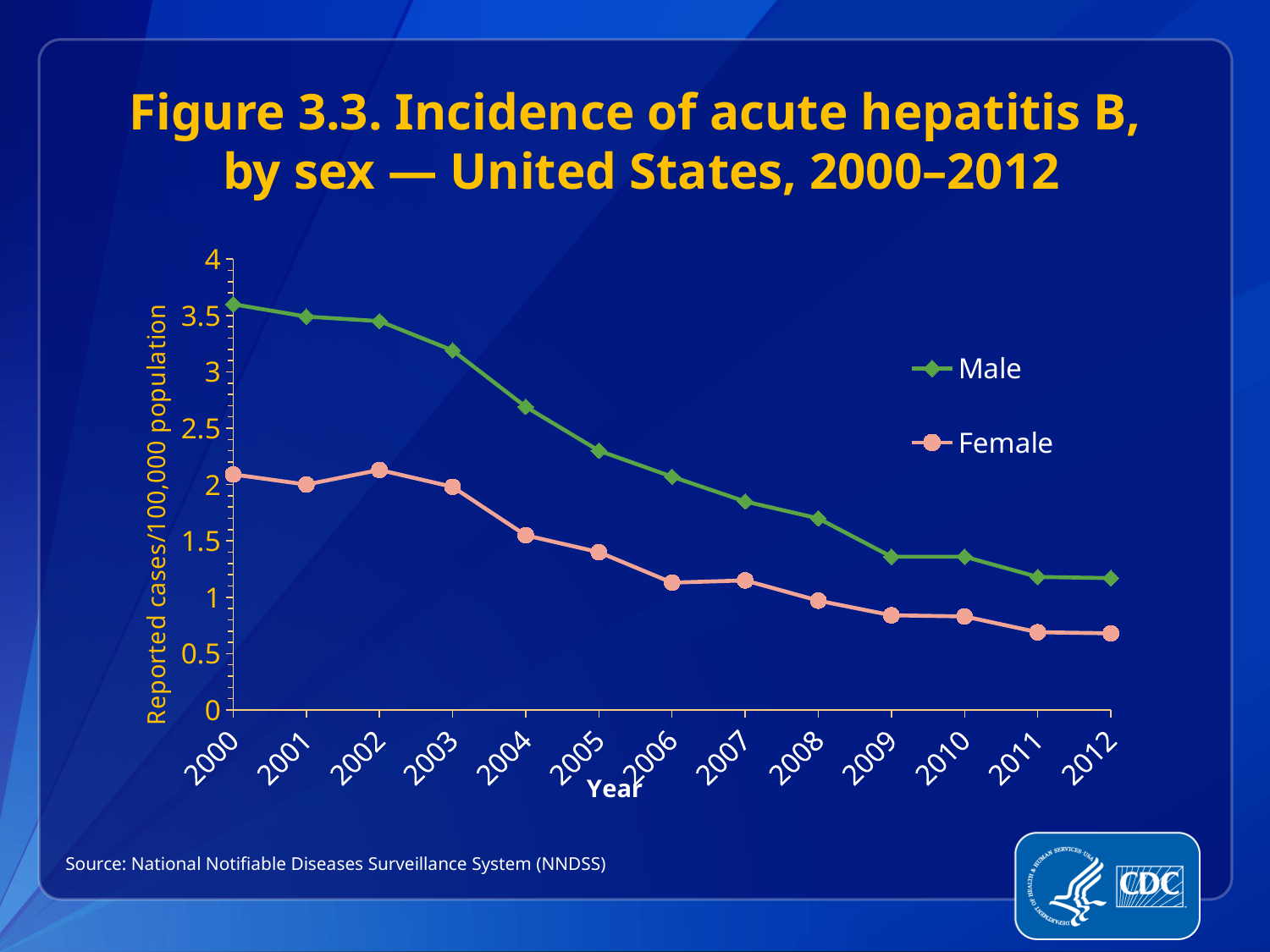
Do the Male values rise or fall from 2000 to 2012? fall Is the Female value for 2000 greater or less than 2.5? less How many series does the legend list? 2 How many years are plotted along the x axis? 13 Which series has the larger value in 2005, Male or Female? Male Is the Male value for 2009 greater or less than 1.5? less What kind of chart is shown on the slide? line chart Is the Male value for 2000 greater or less than 3? greater What is the label of the y axis? Reported cases/100,000 population In which year is the Male incidence highest? 2000